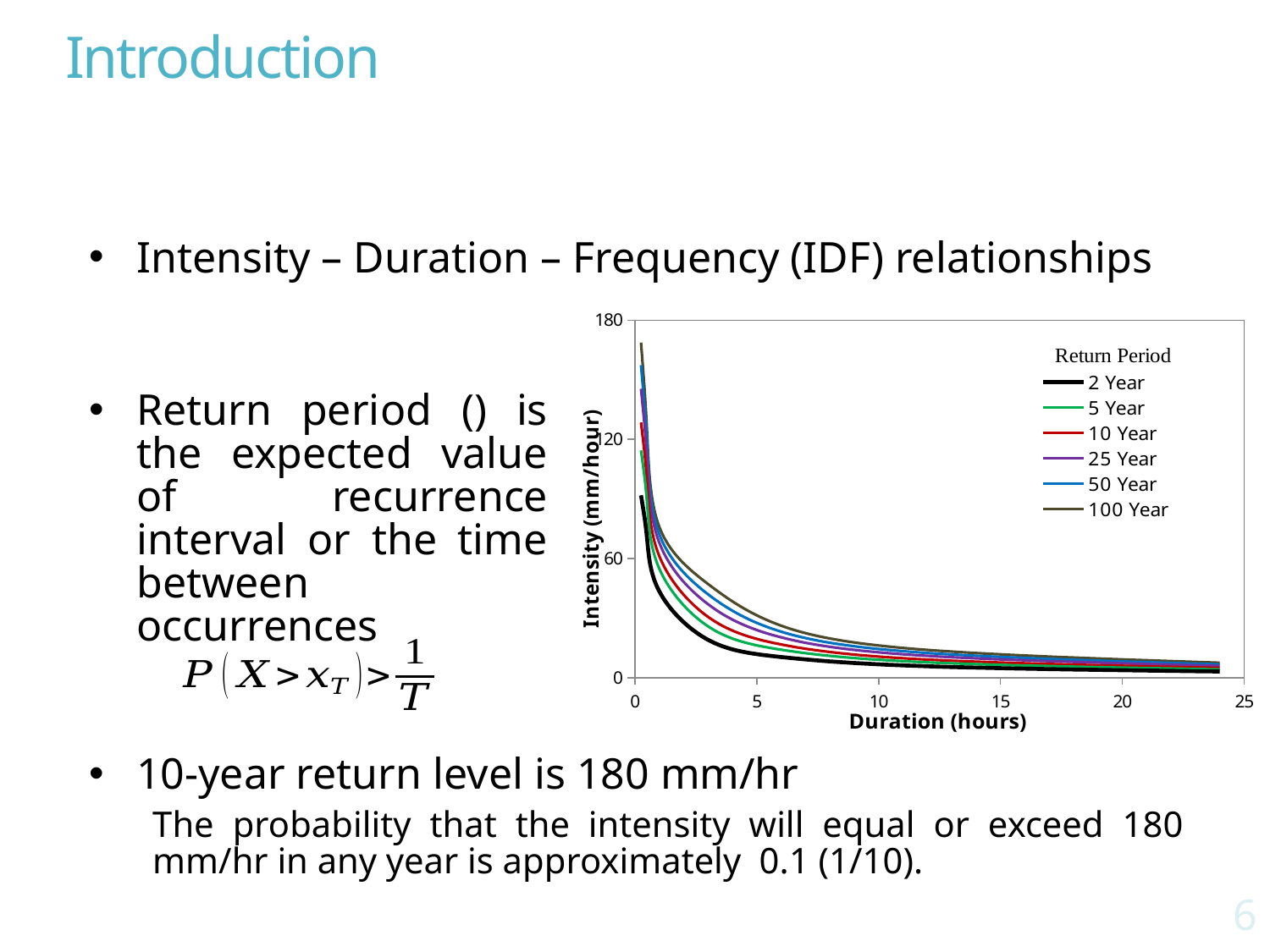
What kind of chart is shown on the slide? line chart Which return period series has the highest intensity at short durations? 100 Year Do the intensity values rise or fall as duration increases along the x axis? fall Is the intensity of the 100 Year series at a duration of 20 hours greater or less than 60? less Is the intensity of the 2 Year series at a duration of 5 hours greater or less than 60? less What is the title of the chart's legend? Return Period Is the peak intensity of the 2 Year series at the shortest duration greater or less than 120? less How many series does the chart's legend list? 6 What is the label of the chart's x axis? Duration (hours) At a duration of 1 hour, which series has the larger intensity, 100 Year or 2 Year? 100 Year Which return period series has the lowest intensity across the durations? 2 Year